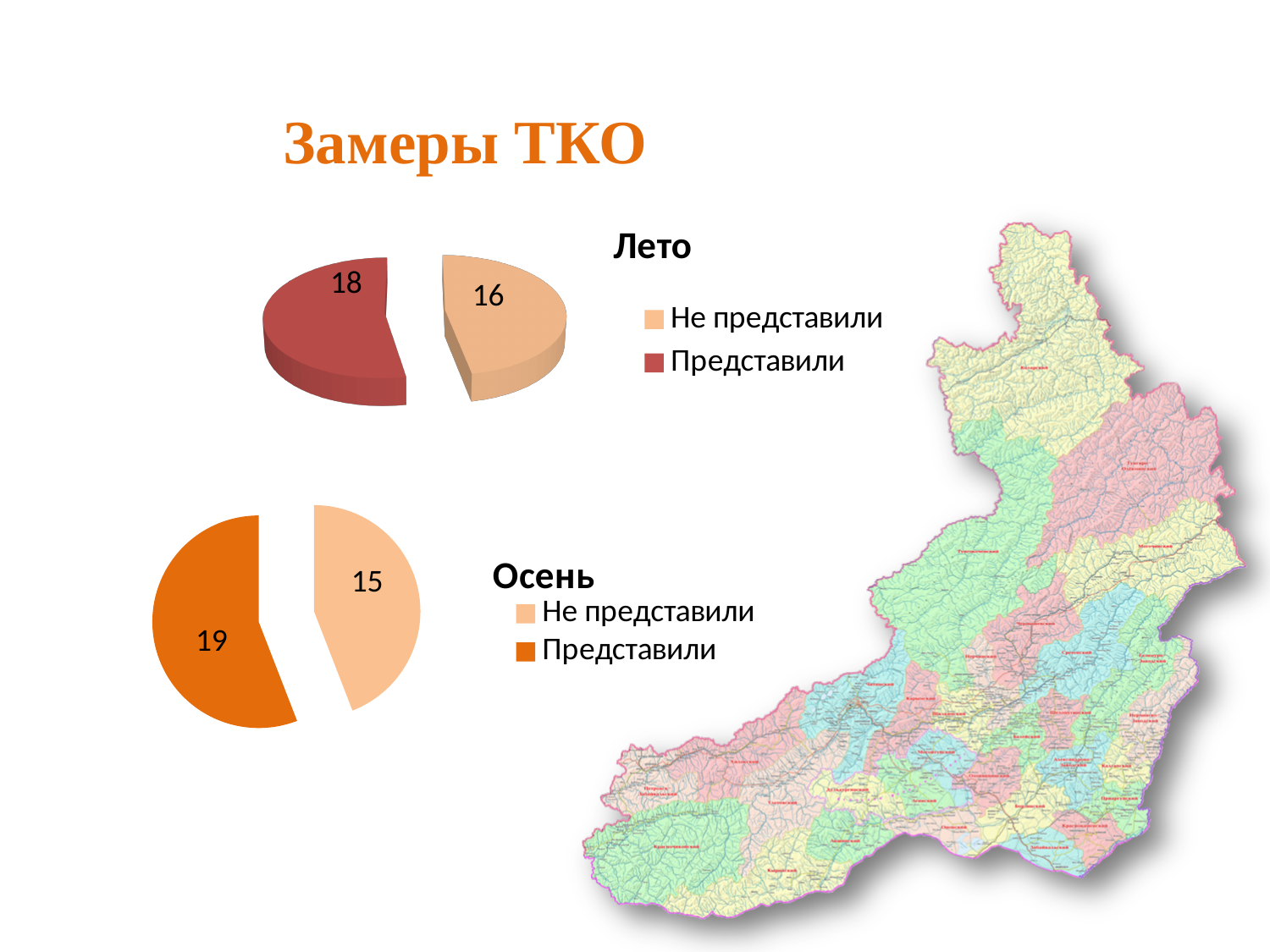
In the Осень pie chart, which category has the smaller value? Не представили In the Лето pie chart, what is the value for Представили? 18 Is the value for Представили larger in the Лето chart or in the Осень chart? Осень In the Лето pie chart, what is the value for Не представили? 16 What is the title of the slide containing the two pie charts? Замеры ТКО In the Лето pie chart, what is the difference between Представили and Не представили? 2 What type of chart is used for Лето? Pie chart In the Лето pie chart, which category has the larger value? Представили In the Осень pie chart, what is the value for Представили? 19 In the Осень pie chart, what is the value for Не представили? 15 How many categories does the Осень pie chart show? 2 In the Осень pie chart, what is the difference between Представили and Не представили? 4